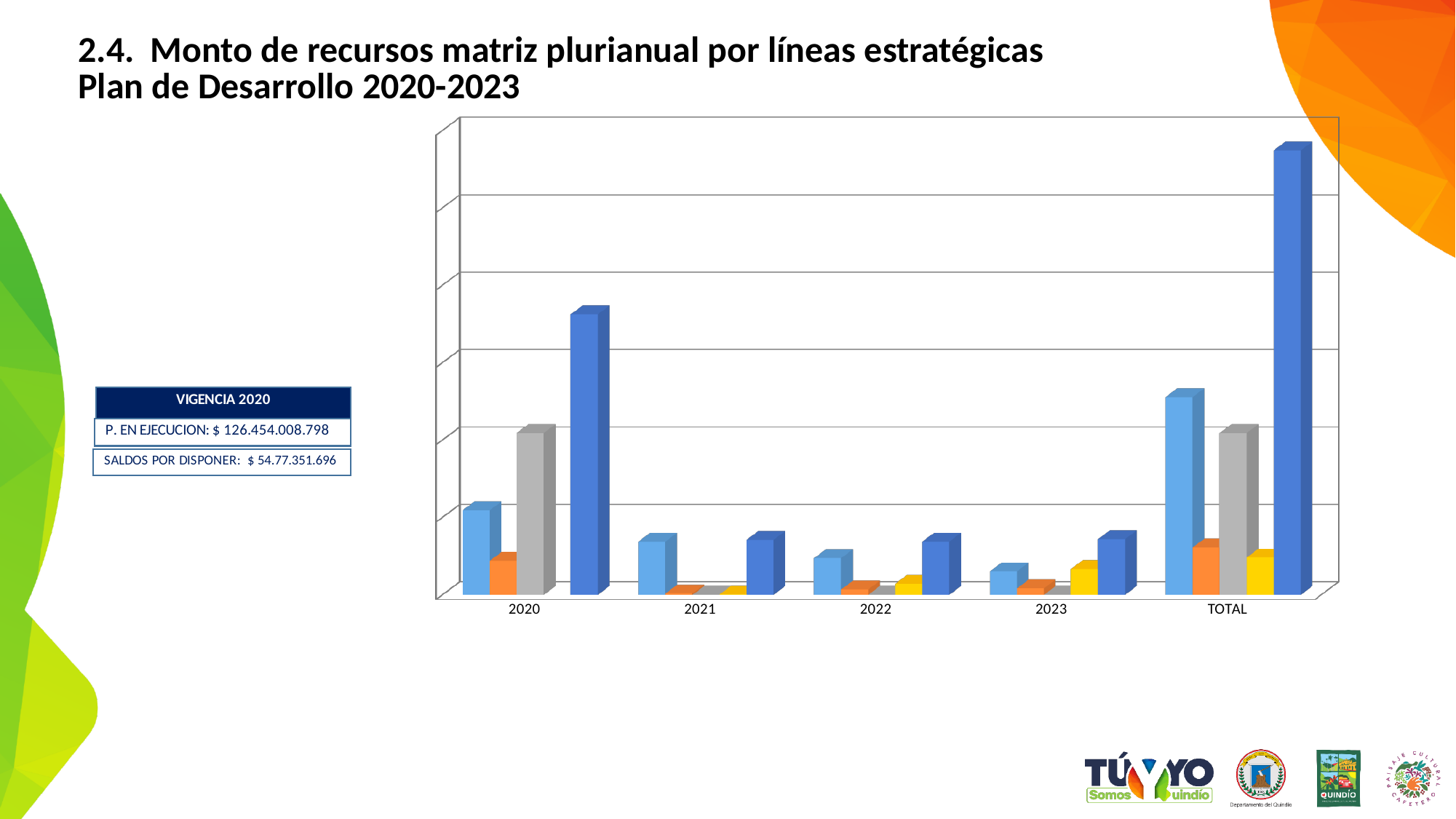
In the 2023 group, which is taller: the yellow bar or the orange bar? yellow bar How many categories are labelled on the x axis of the chart? 5 In the TOTAL group, which is taller: the light blue bar or the gray bar? light blue bar Among the years 2020 to 2023, which year has the shortest light blue bar? 2023 Among the years 2020 to 2023, which year has the tallest dark blue bar? 2020 In the 2020 group, which is taller: the dark blue bar or the gray bar? dark blue bar Do the light blue bars rise or fall from 2020 to 2023? fall Which x-axis category contains the tallest bar in the chart? TOTAL Do the dark blue bars rise or fall from 2020 to 2023? fall What kind of chart is shown on the slide? bar chart